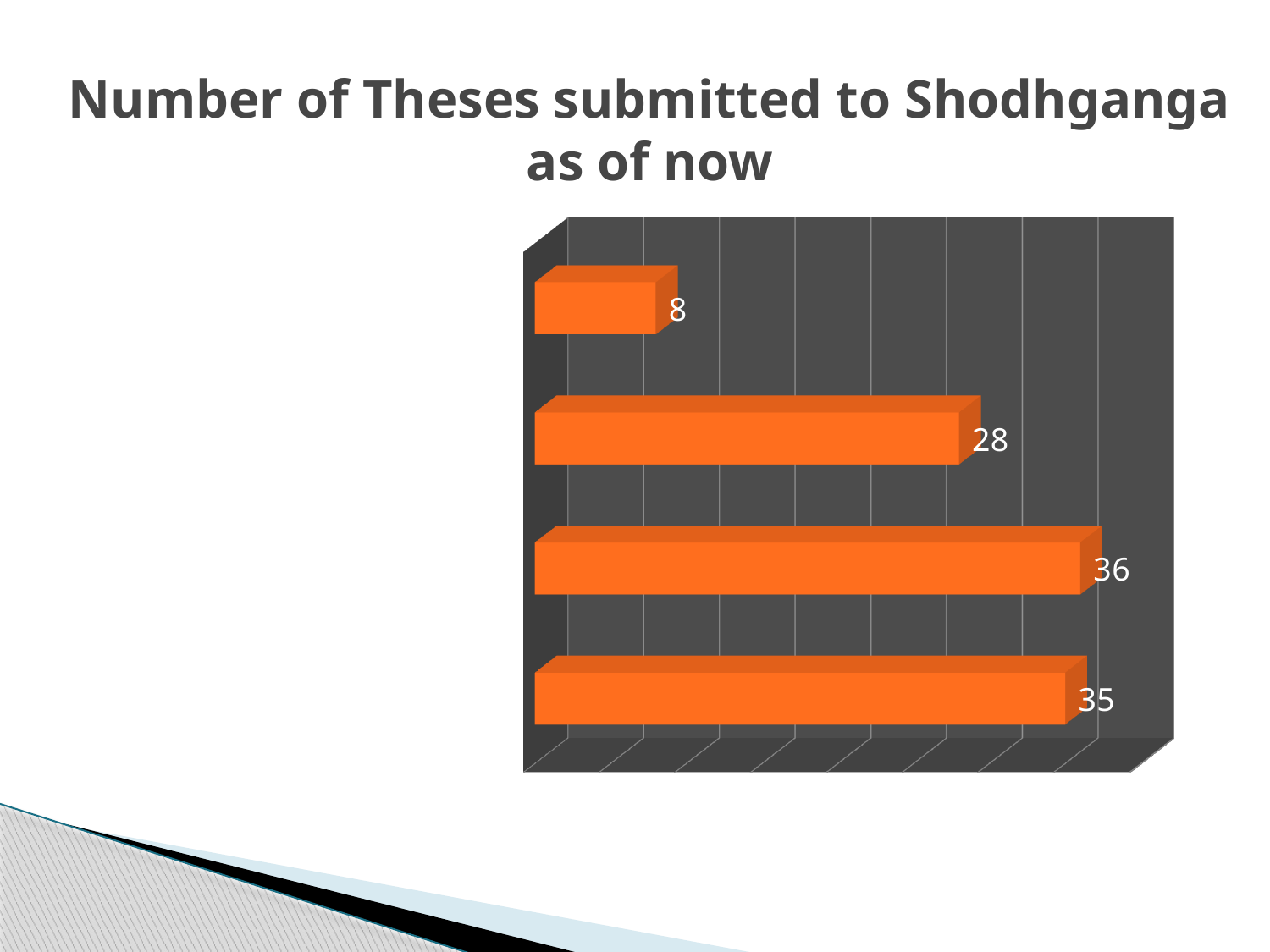
What is the value shown on the second bar from the top? 28 Which bar has the larger value, the second bar from the top or the bottom bar? the bottom bar What is the total of all four bar values in the chart? 107 What is the value shown on the bottom bar of the chart? 35 What is the highest value labelled on any bar in the chart? 36 What is the difference between the value of the third bar from the top (36) and the top bar (8)? 28 How many bars does the chart contain? 4 What is the value shown on the top bar of the chart? 8 What kind of chart is shown on the slide? bar chart What is the value shown on the third bar from the top? 36 What is the lowest value labelled on any bar in the chart? 8 What colour are the bars in the chart? orange